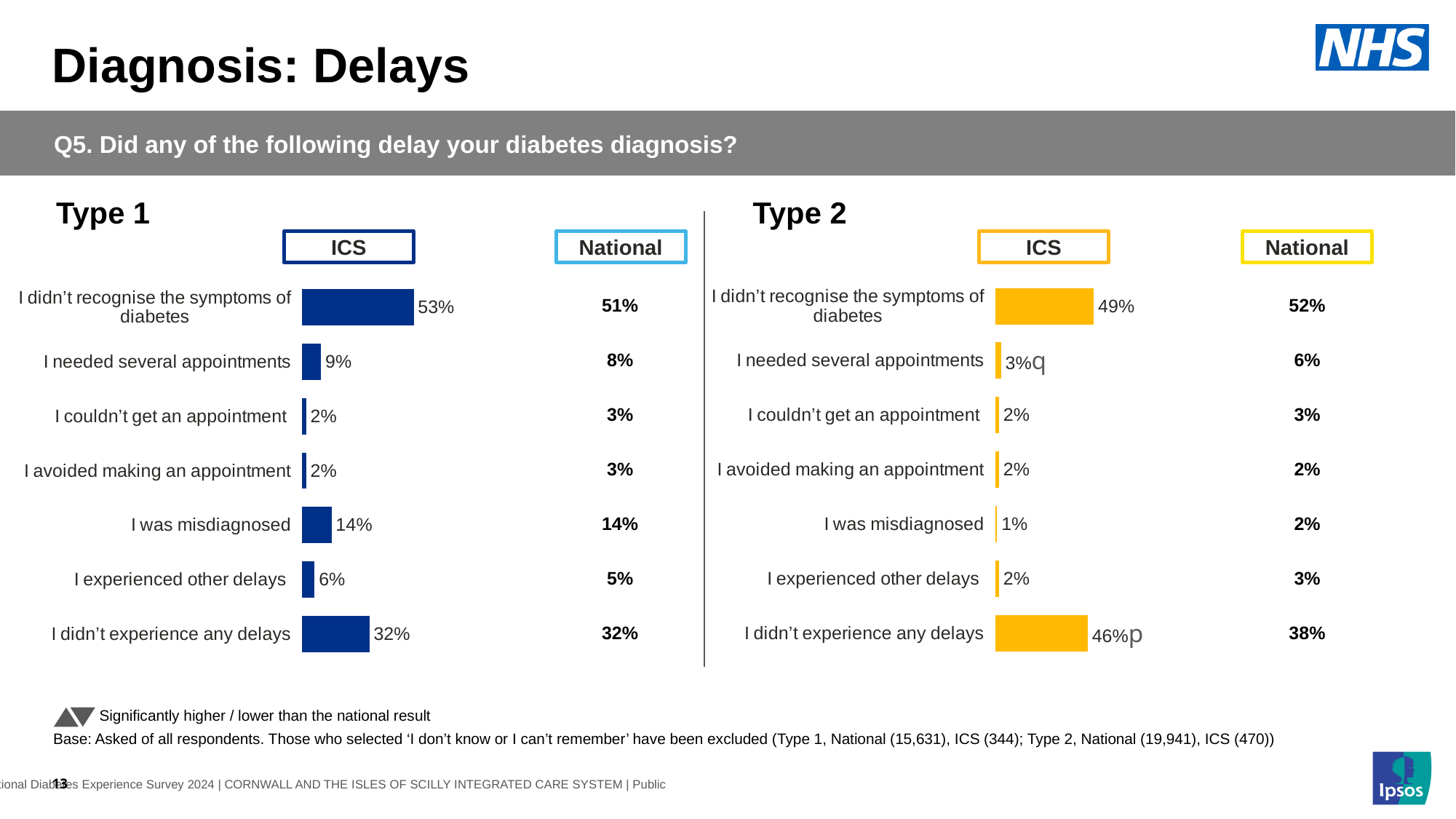
In the Type 2 chart, which is larger for 'I didn't recognise the symptoms of diabetes': the ICS value or the National value? National In the Type 1 chart, what is the difference between the ICS values for 'I didn't recognise the symptoms of diabetes' and 'I didn't experience any delays'? 21 percentage points What colour are the ICS bars in the Type 2 chart? Yellow/orange In the Type 1 chart, what is the National value for 'I was misdiagnosed'? 14% In the Type 1 chart, which category has the highest ICS value? I didn't recognise the symptoms of diabetes In the Type 2 chart, what is the difference between the ICS and National values for 'I didn't experience any delays'? 8 percentage points How many categories are shown in the Type 1 chart? 7 In the Type 1 chart, what is the ICS value for 'I didn't recognise the symptoms of diabetes'? 53% What kind of chart is used to show the ICS values in the Type 1 section? Bar chart In the Type 2 chart, what is the ICS value for 'I didn't experience any delays'? 46% In the Type 2 chart, what is the National value for 'I needed several appointments'? 6% In the Type 2 chart, which category has the lowest ICS value? I was misdiagnosed